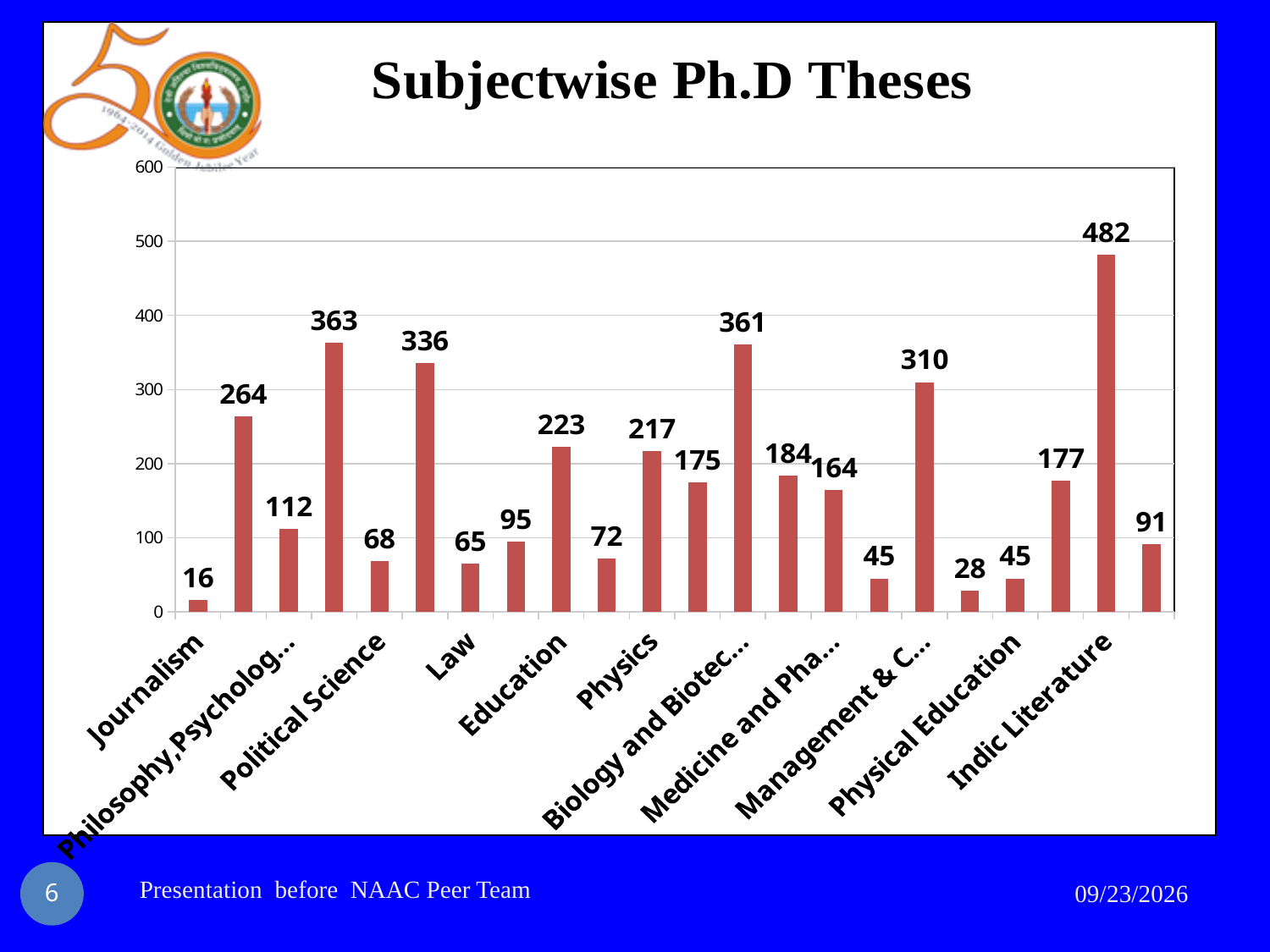
Which labelled subject has the highest number of Ph.D theses? Indic Literature How many bars are plotted in the chart? 22 What is the difference between the values for Education and Physics? 6 Which labelled subject has the lowest number of Ph.D theses? Journalism What type of chart is shown on the slide? Bar chart What is the number of Ph.D theses for Journalism? 16 What is the value shown for Physics? 217 What is the value shown for Education? 223 What is the value shown for Law? 65 Which has more Ph.D theses, Political Science or Physical Education? Political Science What is the number of Ph.D theses for Indic Literature? 482 Is the value for Indic Literature greater or less than 400? greater